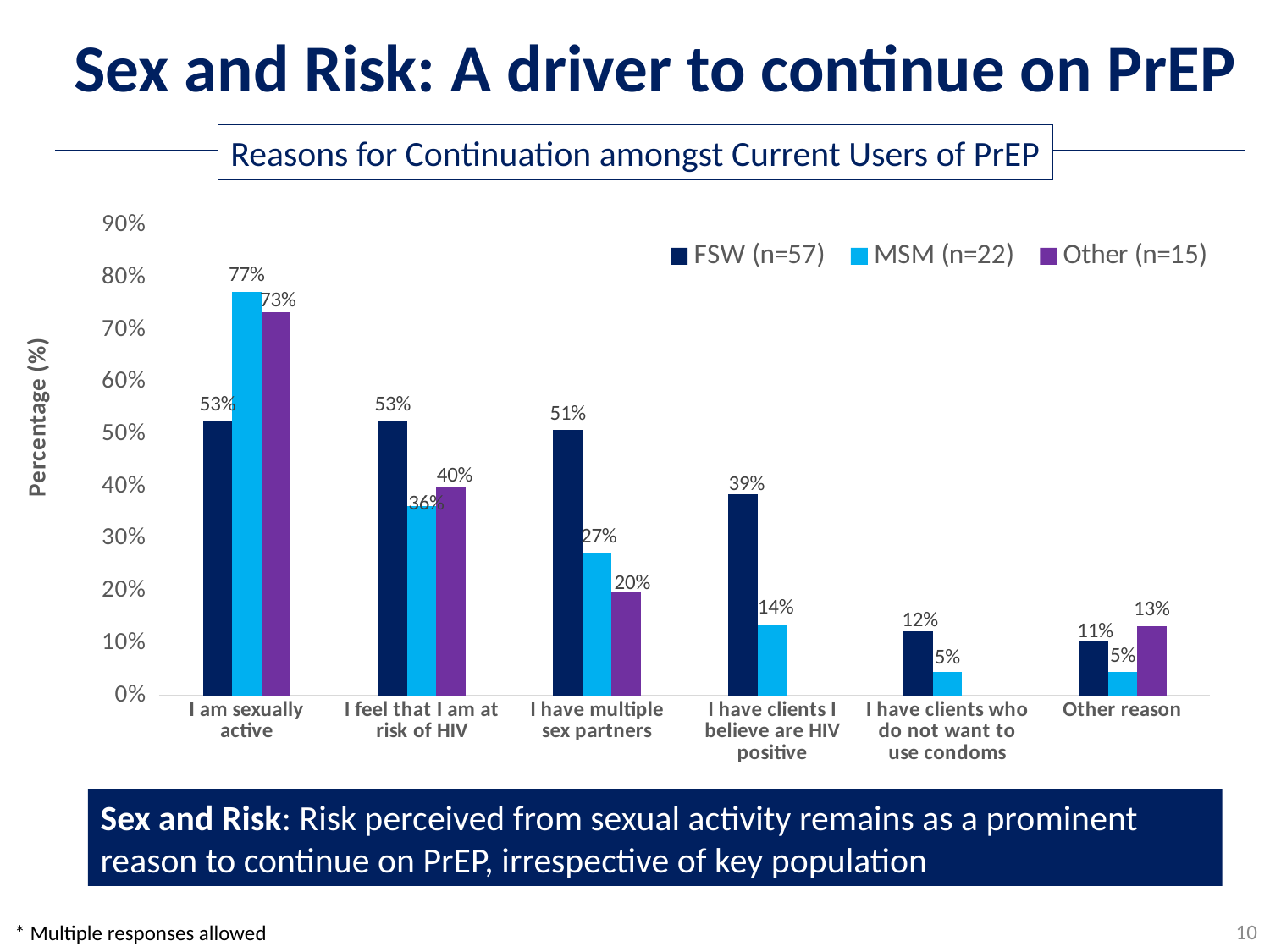
Which series has the highest value in the category 'I am sexually active'? MSM (n=22) What kind of chart is shown on the slide? Bar chart For 'I feel that I am at risk of HIV', which is larger: the FSW (n=57) value or the Other (n=15) value? FSW (n=57) What is the value for Other (n=15) in the category 'Other reason'? 13% Is the value for MSM (n=22) in 'I have multiple sex partners' greater or less than 30%? less What is the difference between the FSW (n=57) and MSM (n=22) values for 'I have clients I believe are HIV positive'? 25 percentage points What is the label on the y axis of the chart? Percentage (%) What is the value for MSM (n=22) in the category 'I am sexually active'? 77% Which series has the lowest value in the category 'I have multiple sex partners'? Other (n=15) How many series does the legend list? 3 How many reason categories are shown on the x axis? 6 What is the value for FSW (n=57) in the category 'I have multiple sex partners'? 51%